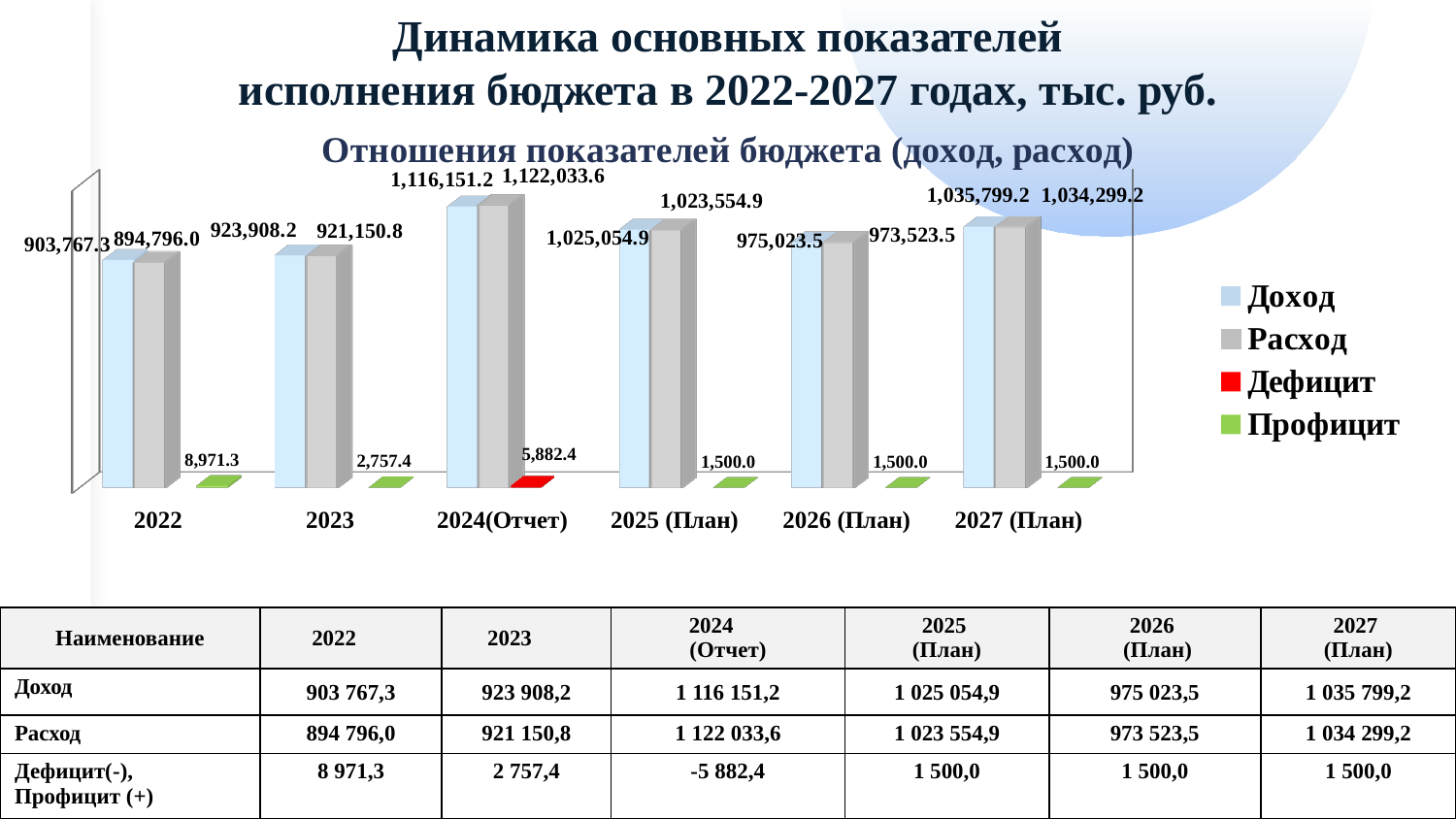
In 2025 (План), which is larger, Доход or Расход? Доход How many series does the legend list? 4 What is the value of Дефицит for 2024(Отчет)? 5,882.4 What is the value of Расход for 2024(Отчет)? 1,122,033.6 Which year has the highest Доход? 2024(Отчет) How many years are shown on the x axis? 6 What kind of chart is this? Bar chart Which year has the lowest Доход? 2022 Does Доход rise or fall from 2024(Отчет) to 2026 (План)? Fall What is the value of Доход for 2022? 903,767.3 What is the value of Профицит for 2023? 2,757.4 What is the difference between Доход and Расход in 2022? 8,971.3